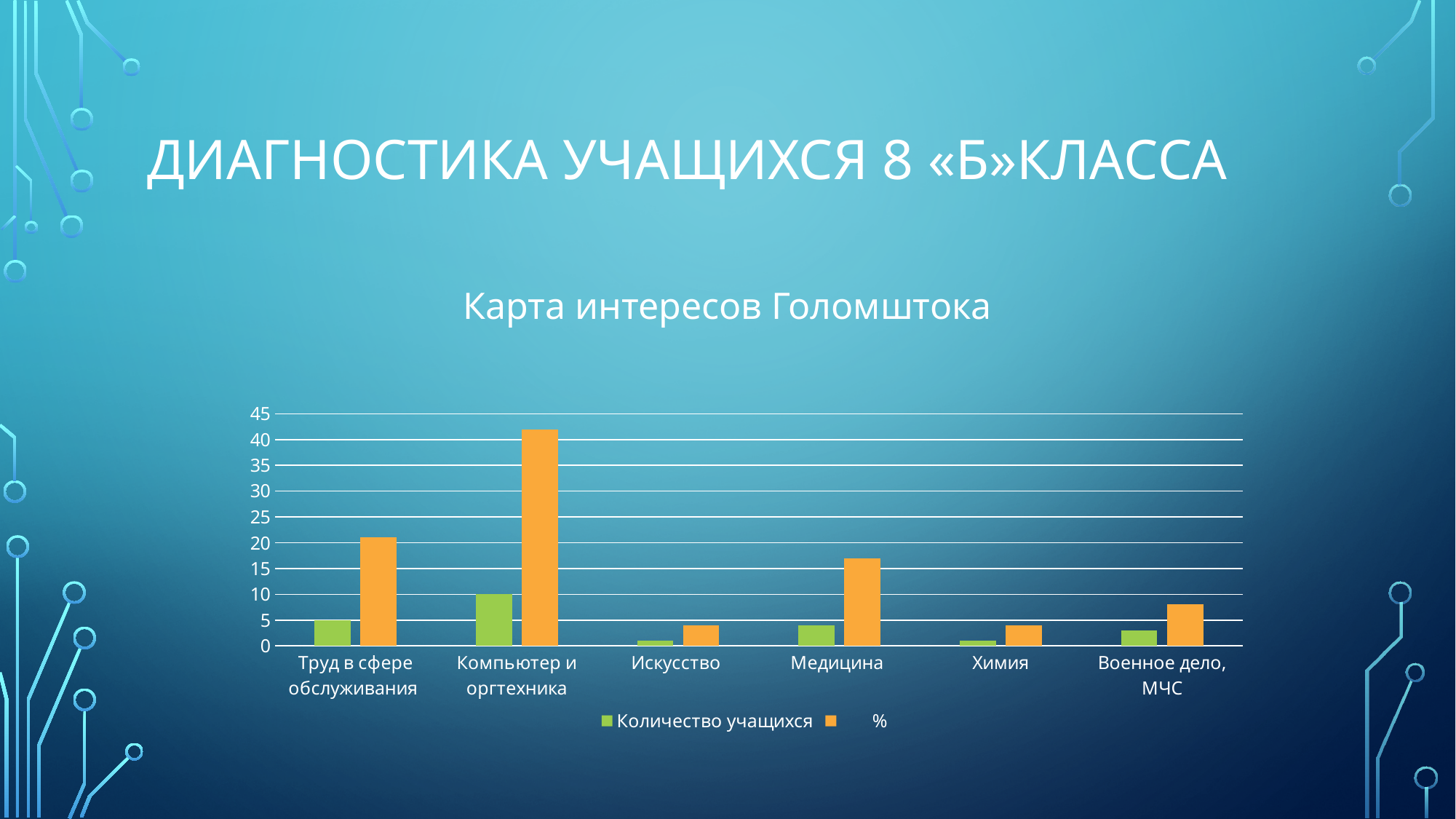
Which category has the highest value for the % series? Компьютер и оргтехника How many series does the legend list? 2 Which is larger for the % series: Медицина or Химия? Медицина What is the title of the chart? Карта интересов Голомштока Which category has the highest value for Количество учащихся? Компьютер и оргтехника Is the % value for Компьютер и оргтехника greater or less than 40? greater Is the % value for Военное дело, МЧС greater or less than 10? less Is the % value for Медицина greater or less than 20? less Which colour represents the % series in the legend? orange What kind of chart is shown on the slide? bar chart How many categories are shown on the x axis? 6